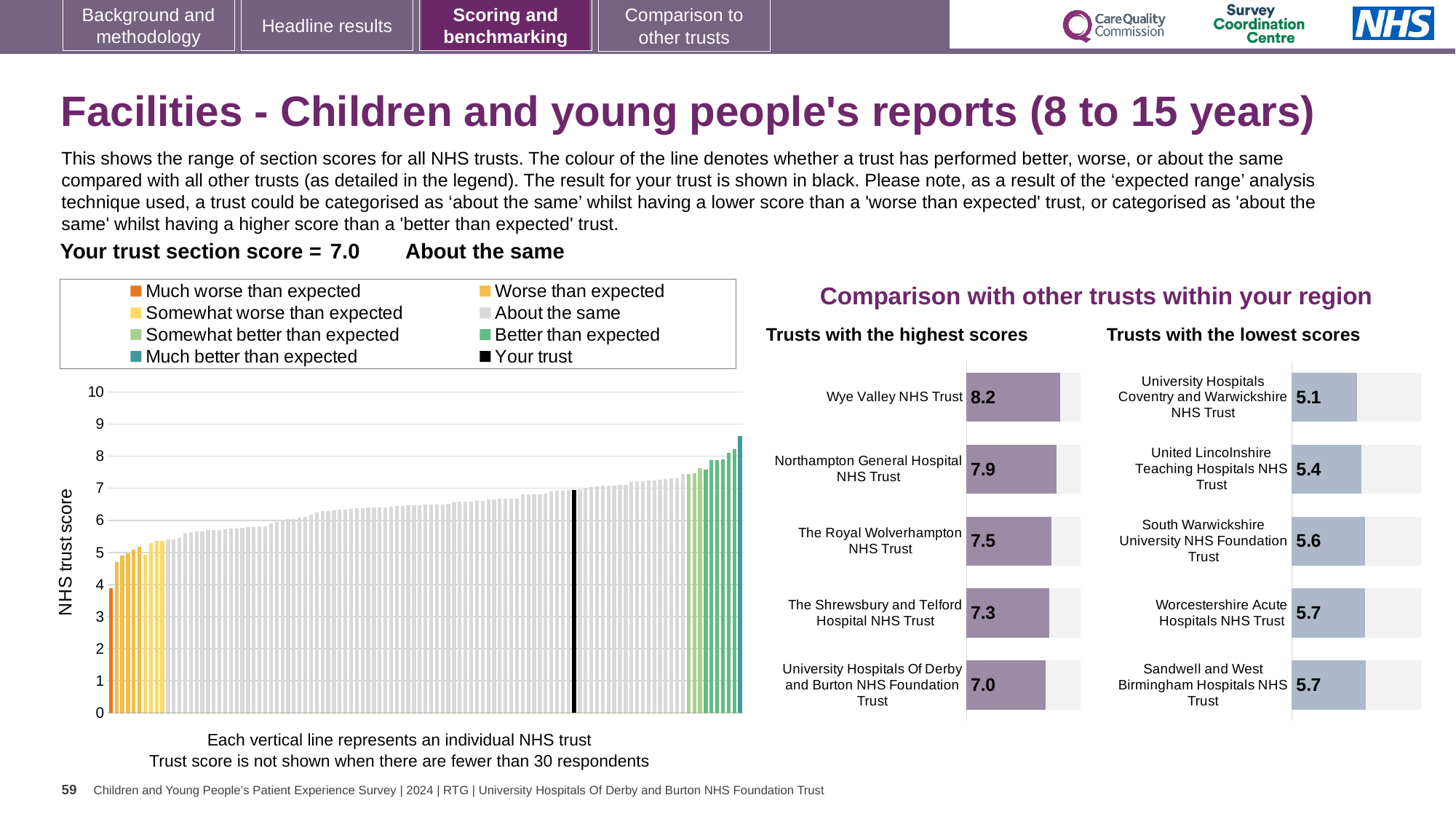
In the large chart on the left showing all NHS trusts, is the value of the highest bar greater or less than 8? greater In the 'Trusts with the lowest scores' chart, which trust has the lowest score? University Hospitals Coventry and Warwickshire NHS Trust In the 'Trusts with the highest scores' chart, what is the score for Wye Valley NHS Trust? 8.2 How many entries does the legend of the large chart on the left list? 8 In the 'Trusts with the highest scores' chart, what is the difference between the scores of Wye Valley NHS Trust and University Hospitals Of Derby and Burton NHS Foundation Trust? 1.2 In the large chart on the left showing all NHS trusts, is the value of the lowest bar greater or less than 5? less In the 'Trusts with the highest scores' chart, what is the score for The Royal Wolverhampton NHS Trust? 7.5 In the 'Trusts with the highest scores' chart, which trust has the highest score? Wye Valley NHS Trust How many trusts are shown in the 'Trusts with the highest scores' chart? 5 In the 'Trusts with the lowest scores' chart, which has the higher score: United Lincolnshire Teaching Hospitals NHS Trust or South Warwickshire University NHS Foundation Trust? South Warwickshire University NHS Foundation Trust In the 'Trusts with the lowest scores' chart, what is the difference between the scores of Worcestershire Acute Hospitals NHS Trust and University Hospitals Coventry and Warwickshire NHS Trust? 0.6 In the 'Trusts with the lowest scores' chart, what is the score for United Lincolnshire Teaching Hospitals NHS Trust? 5.4